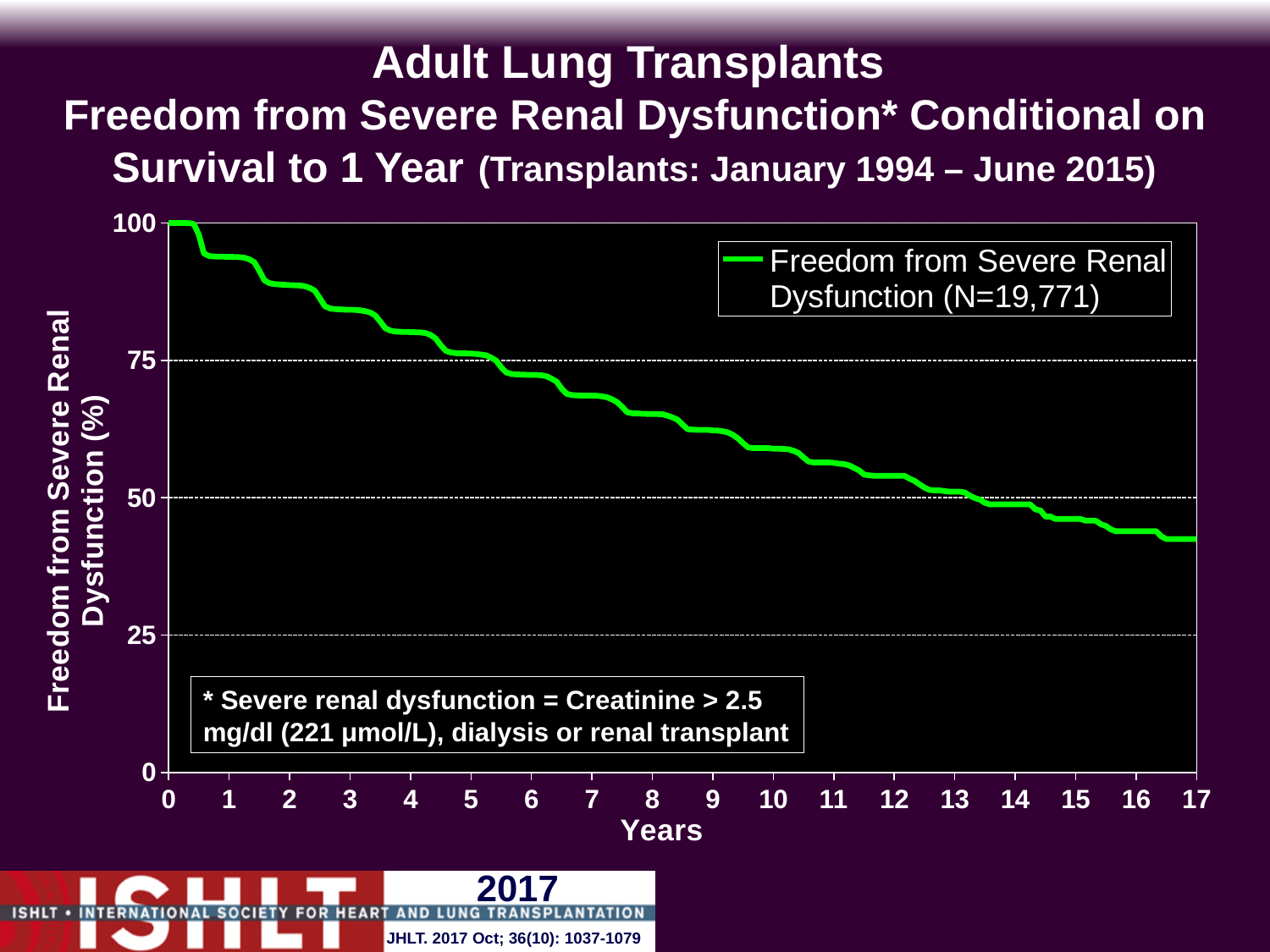
Is the freedom from severe renal dysfunction at year 8 greater or less than 75? less Is the freedom from severe renal dysfunction at year 2 greater or less than 75? greater What is the freedom from severe renal dysfunction value at year 0? 100 What is the N given in the legend for the Freedom from Severe Renal Dysfunction series? N=19,771 How many series does the legend list? 1 What kind of chart is shown on the slide? line chart Is the freedom from severe renal dysfunction at year 17 greater or less than 50? less Does freedom from severe renal dysfunction rise or fall as years increase? fall Is the value at year 3 larger or smaller than the value at year 12? larger What is the label of the x axis? Years